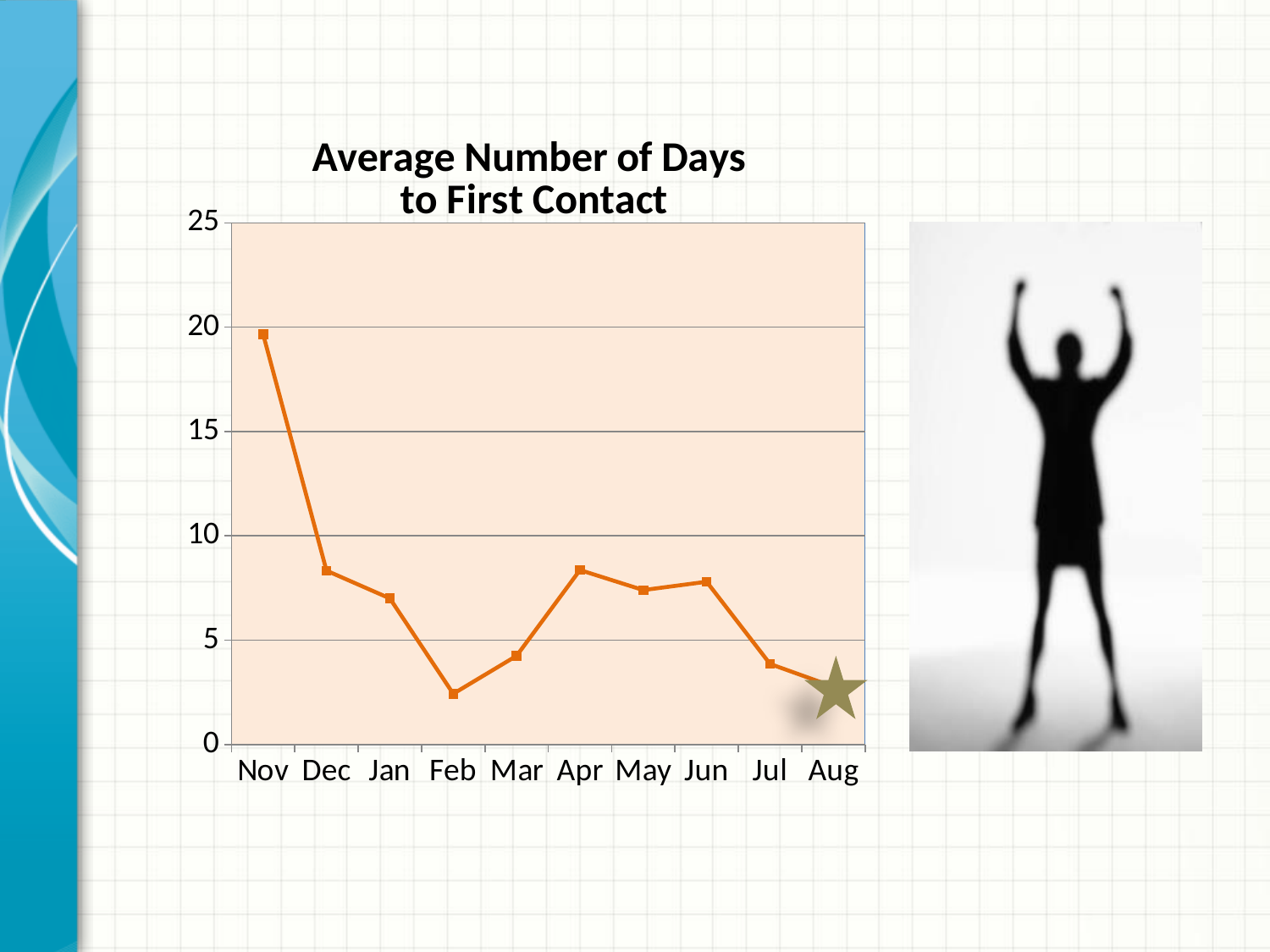
What is the title of the chart? Average Number of Days to First Contact Is the value for Apr greater or less than 5? greater Is the value for Dec greater or less than 10? less Overall, do the values rise or fall from Nov to Aug? fall Is the value for Feb greater or less than 5? less How many months are plotted on the x axis of the chart? 10 Which is larger, the value for Jun or the value for Jul? Jun Which is larger, the value for Nov or the value for Dec? Nov What kind of chart is shown on the slide? line chart Which month has the highest average number of days to first contact? Nov